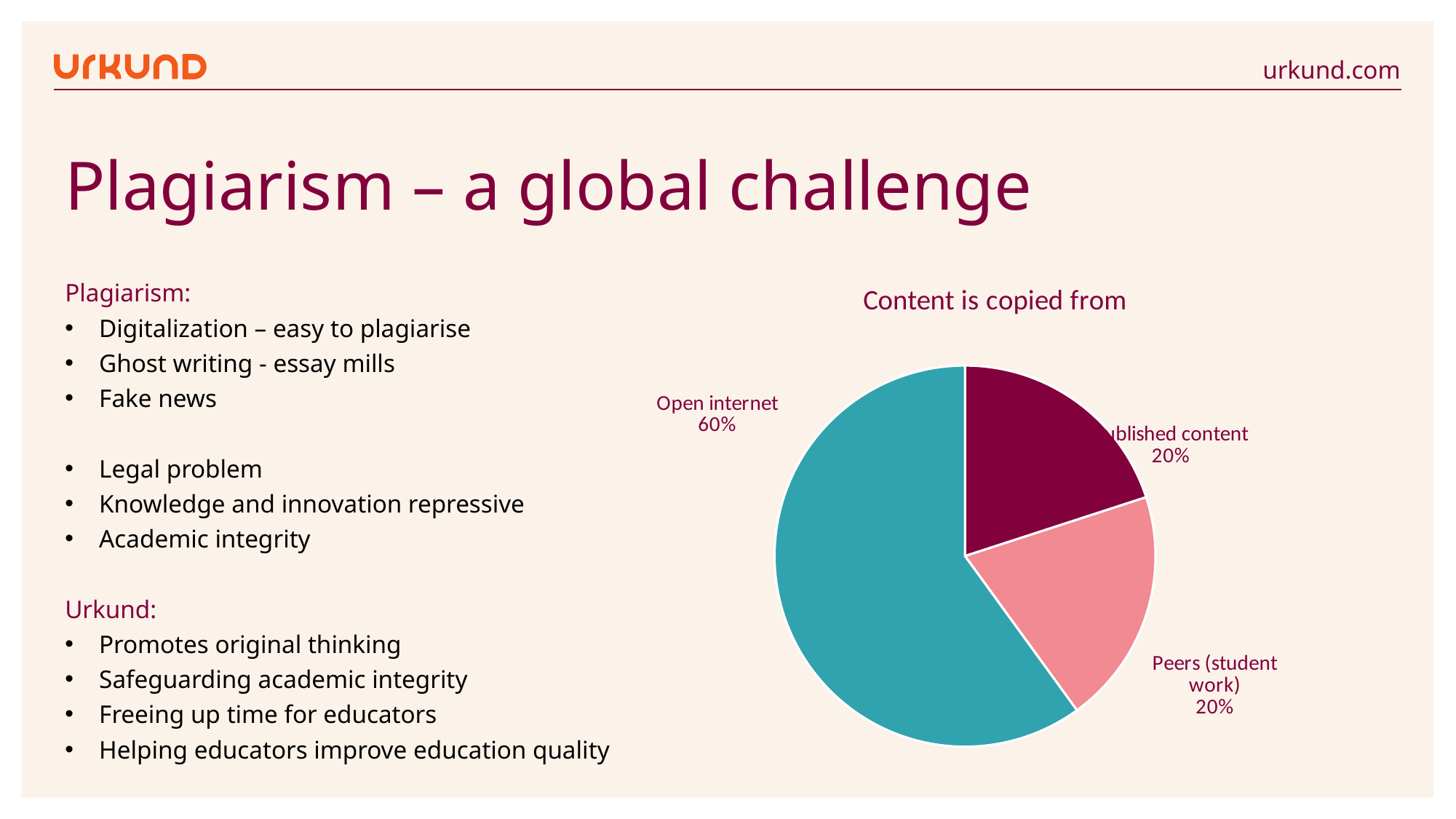
Which category has the largest slice of the pie? Open internet What share of the pie is Published content? 20% What share of the pie is Peers (student work)? 20% What share of the pie is Open internet? 60% How many slices does the pie chart have? 3 What type of chart is shown on the slide? pie chart What colour is the Open internet slice? teal What is the combined share of Published content and Peers (student work)? 40% What is the difference in percentage points between Open internet and Peers (student work)? 40 Is the share for Open internet greater or less than 50%? greater What is the title of the chart? Content is copied from Which is larger, the share for Open internet or the share for Published content? Open internet